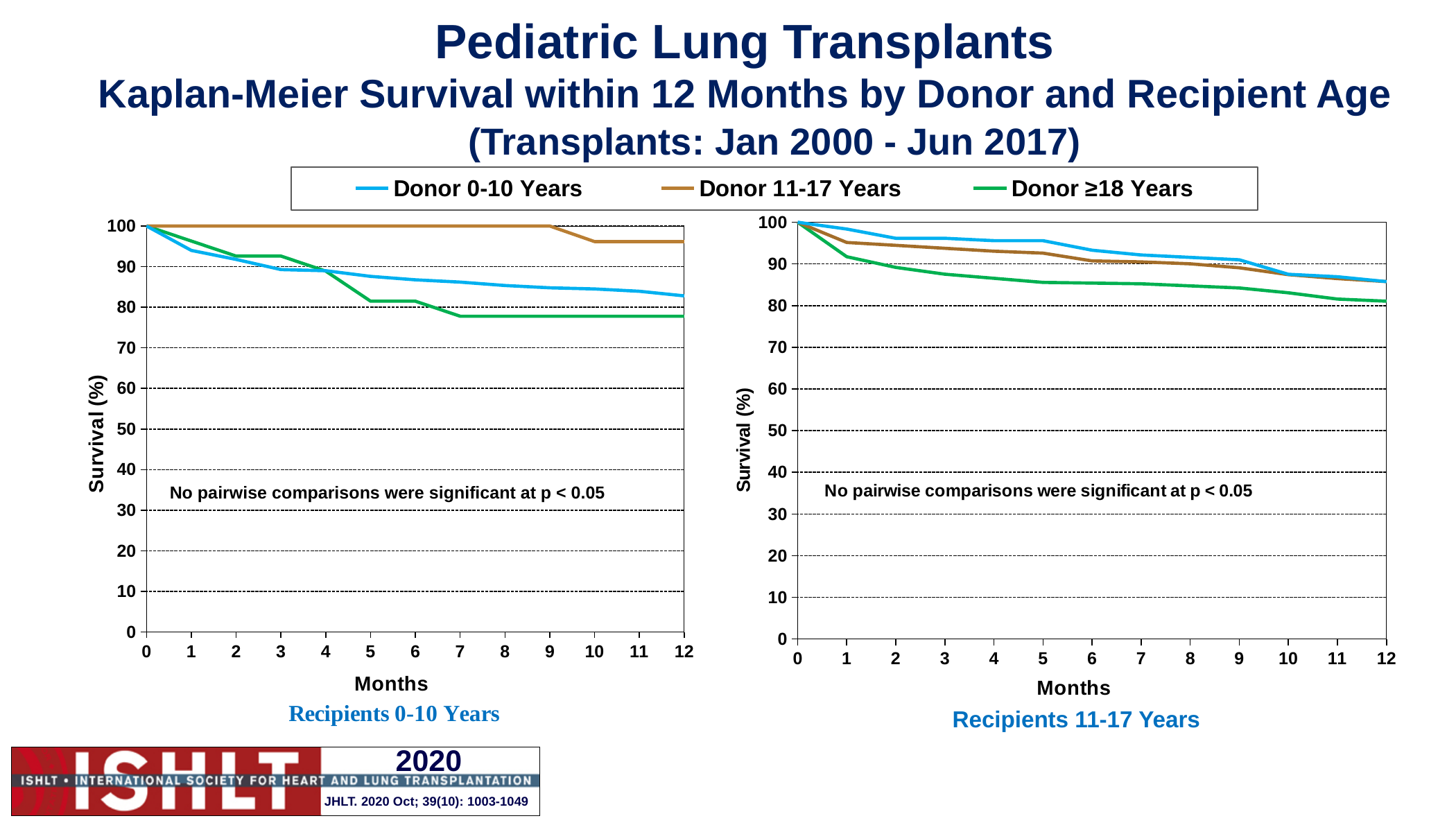
How many series does the legend list? 3 In the Recipients 11-17 Years chart, which donor age group has the lowest survival at 12 months? Donor ≥18 Years In the Recipients 0-10 Years chart, is the survival for Donor ≥18 Years at 12 months greater or less than 80? less In the Recipients 0-10 Years chart, which donor age group has the highest survival at 12 months? Donor 11-17 Years In the Recipients 11-17 Years chart, at 12 months, which is higher: Donor 0-10 Years or Donor ≥18 Years? Donor 0-10 Years What is the label on the y axis of both charts? Survival (%) What kind of chart is shown for Recipients 0-10 Years? Line chart In the Recipients 0-10 Years chart, at month 7, which is higher: Donor 0-10 Years or Donor ≥18 Years? Donor 0-10 Years In the Recipients 11-17 Years chart, does survival rise or fall as months increase? Fall In the Recipients 0-10 Years chart, which donor age group has the lowest survival at 12 months? Donor ≥18 Years In the Recipients 0-10 Years chart, is the survival for Donor 11-17 Years at 12 months greater or less than 90? greater In the Recipients 11-17 Years chart, is the survival for Donor ≥18 Years at month 6 greater or less than 90? less